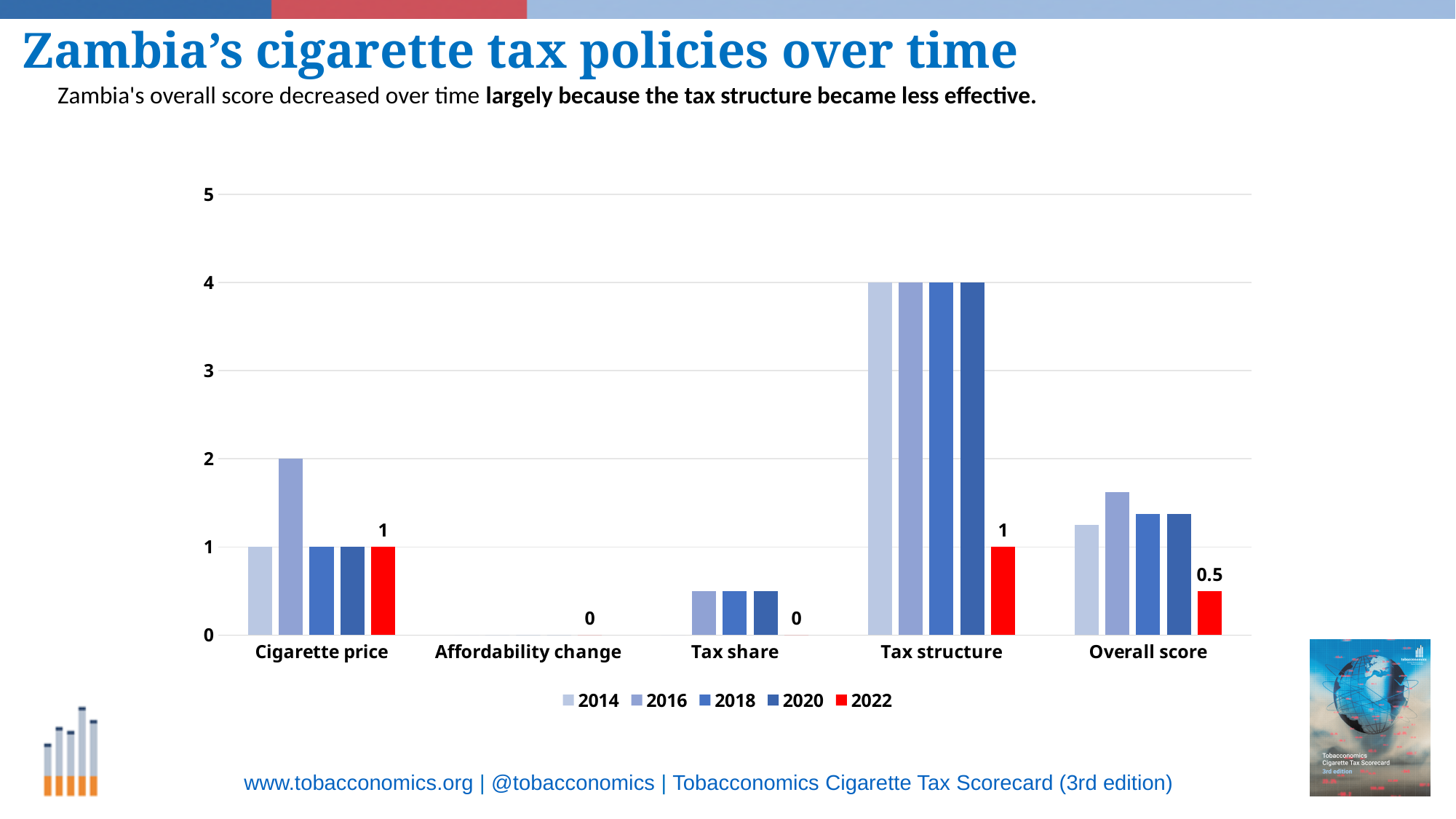
What is the 2022 value for Overall score? 0.5 What kind of chart is shown on the slide? bar chart What is the 2016 value for Cigarette price? 2 For Overall score, which is larger: the 2016 value or the 2022 value? 2016 What is the 2022 value for Affordability change? 0 What is the difference between the 2020 and 2022 values for Tax structure? 3 How many series does the legend list? 5 What is the 2020 value for Tax structure? 4 Is the 2016 value for Overall score greater or less than 1? greater How many categories are shown on the x axis? 5 Which category has the highest value for 2020? Tax structure What is the 2022 value for Tax structure? 1